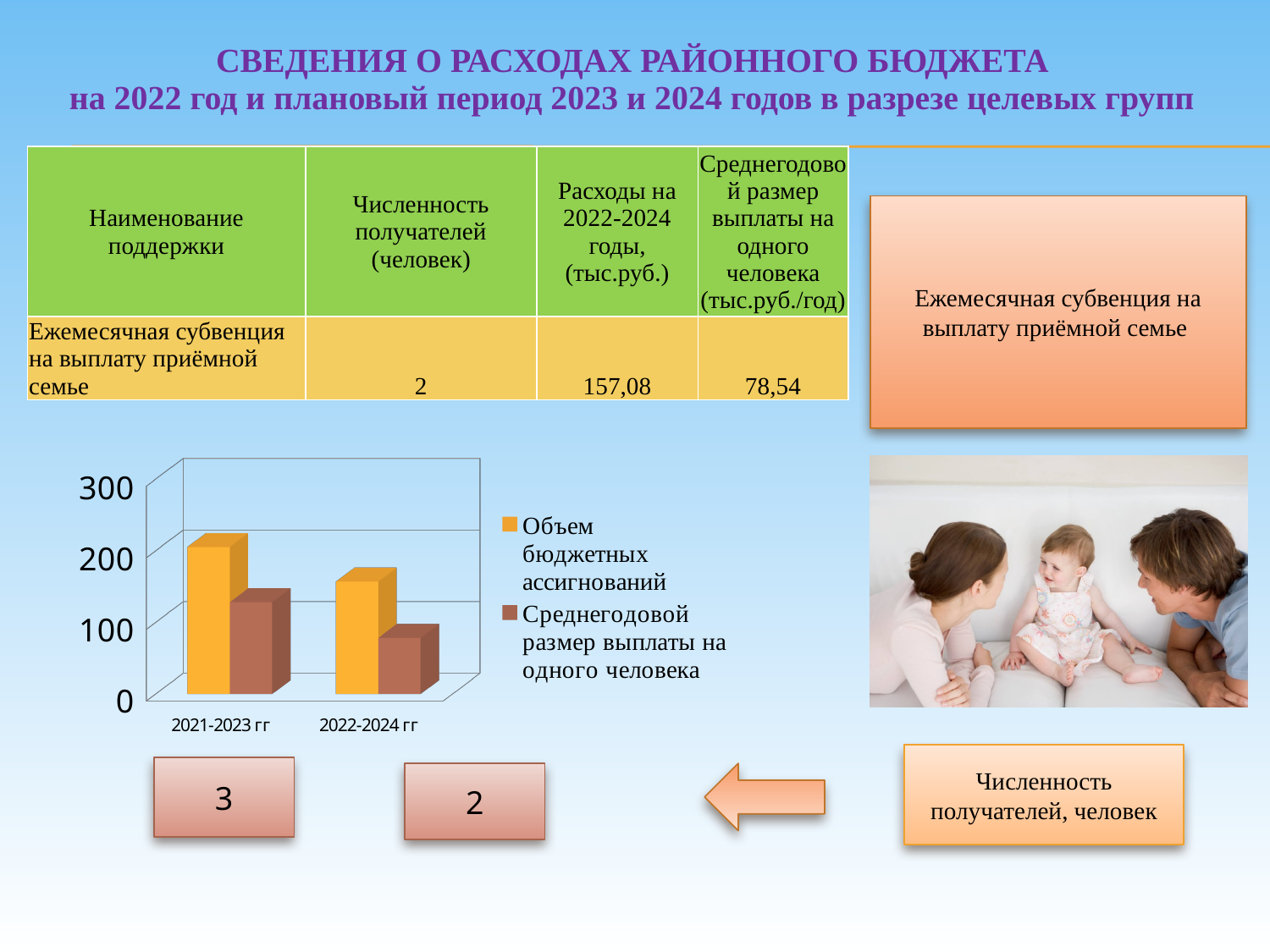
Which category has the lowest value for Среднегодовой размер выплаты на одного человека? 2022-2024 гг What is the highest tick value shown on the vertical axis of the chart? 300 Is the value for Среднегодовой размер выплаты на одного человека in 2022-2024 гг greater or less than 100? less Which category has the highest value for Объем бюджетных ассигнований? 2021-2023 гг How many categories are shown on the x axis of the chart? 2 Do the values for Объем бюджетных ассигнований rise or fall from 2021-2023 гг to 2022-2024 гг? fall Which is larger: Объем бюджетных ассигнований in 2021-2023 гг or in 2022-2024 гг? 2021-2023 гг Is the value for Объем бюджетных ассигнований in 2021-2023 гг greater or less than 100? greater How many series does the chart legend list? 2 What is the first series listed in the chart legend? Объем бюджетных ассигнований What kind of chart is shown on the slide? bar chart Is the value for Объем бюджетных ассигнований in 2022-2024 гг greater or less than 200? less